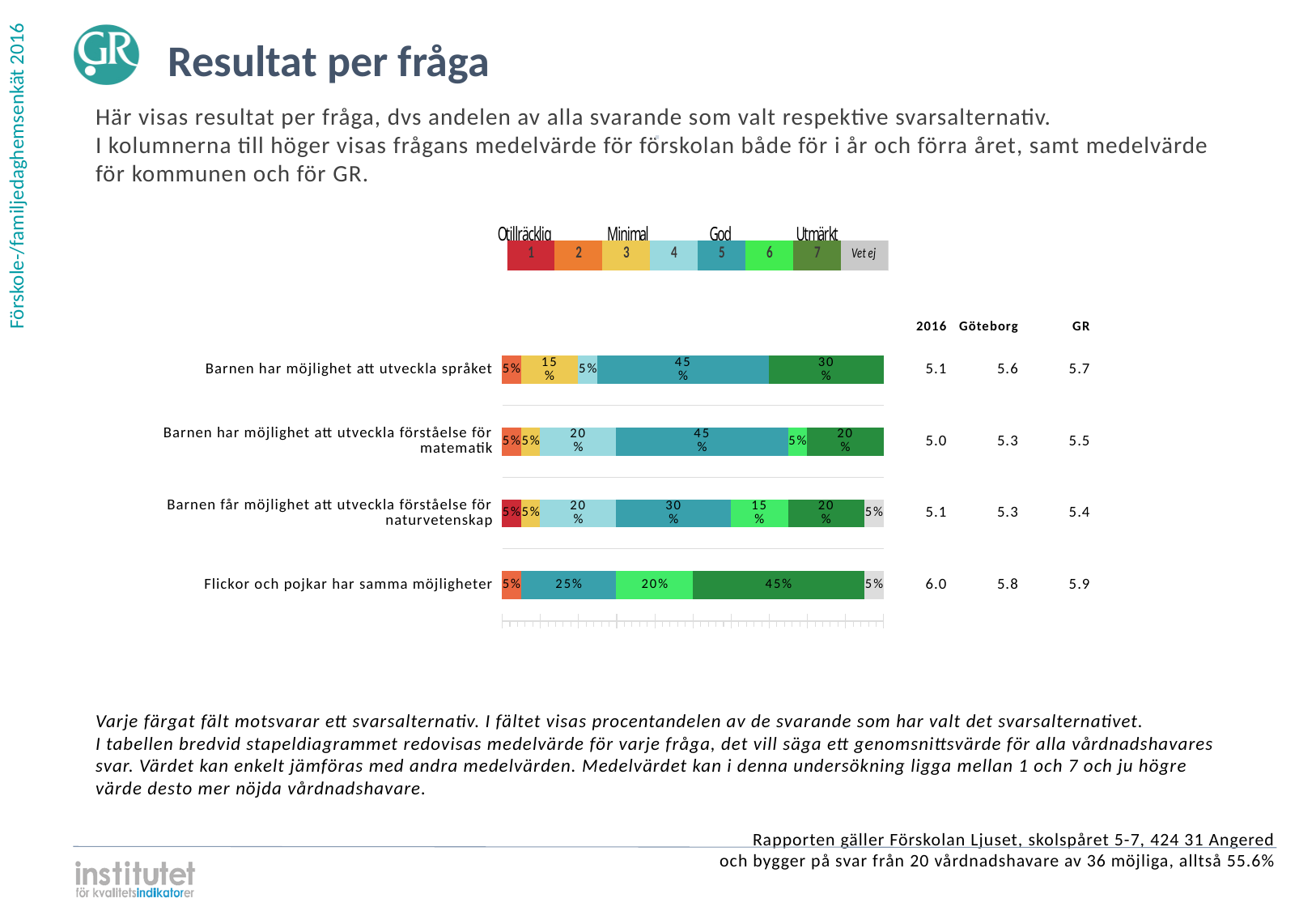
How many answer alternatives does the legend above the chart list? 8 What kind of chart is shown on the slide? Stacked bar chart What percentage of respondents chose alternative 5 (God, teal) for 'Barnen har möjlighet att utveckla språket'? 45% How many questions (categories) are plotted in the bar chart? 4 What percentage chose alternative 6 (bright green) for 'Barnen får möjlighet att utveckla förståelse för naturvetenskap'? 15% What is the GR mean value shown for 'Barnen har möjlighet att utveckla språket'? 5.7 What percentage chose alternative 7 (Utmärkt, dark green) for 'Flickor och pojkar har samma möjligheter'? 45% Which is larger: the alternative 7 (dark green) share for 'Barnen har möjlighet att utveckla språket' or for 'Barnen har möjlighet att utveckla förståelse för matematik'? Barnen har möjlighet att utveckla språket What is the difference between the alternative 5 (teal) share for 'Barnen har möjlighet att utveckla språket' and for 'Barnen får möjlighet att utveckla förståelse för naturvetenskap'? 15% What percentage chose alternative 4 (light blue) for 'Barnen har möjlighet att utveckla förståelse för matematik'? 20% Which question has the largest share of respondents choosing alternative 7 (Utmärkt, dark green)? Flickor och pojkar har samma möjligheter What is the 2016 mean value shown for 'Flickor och pojkar har samma möjligheter'? 6.0